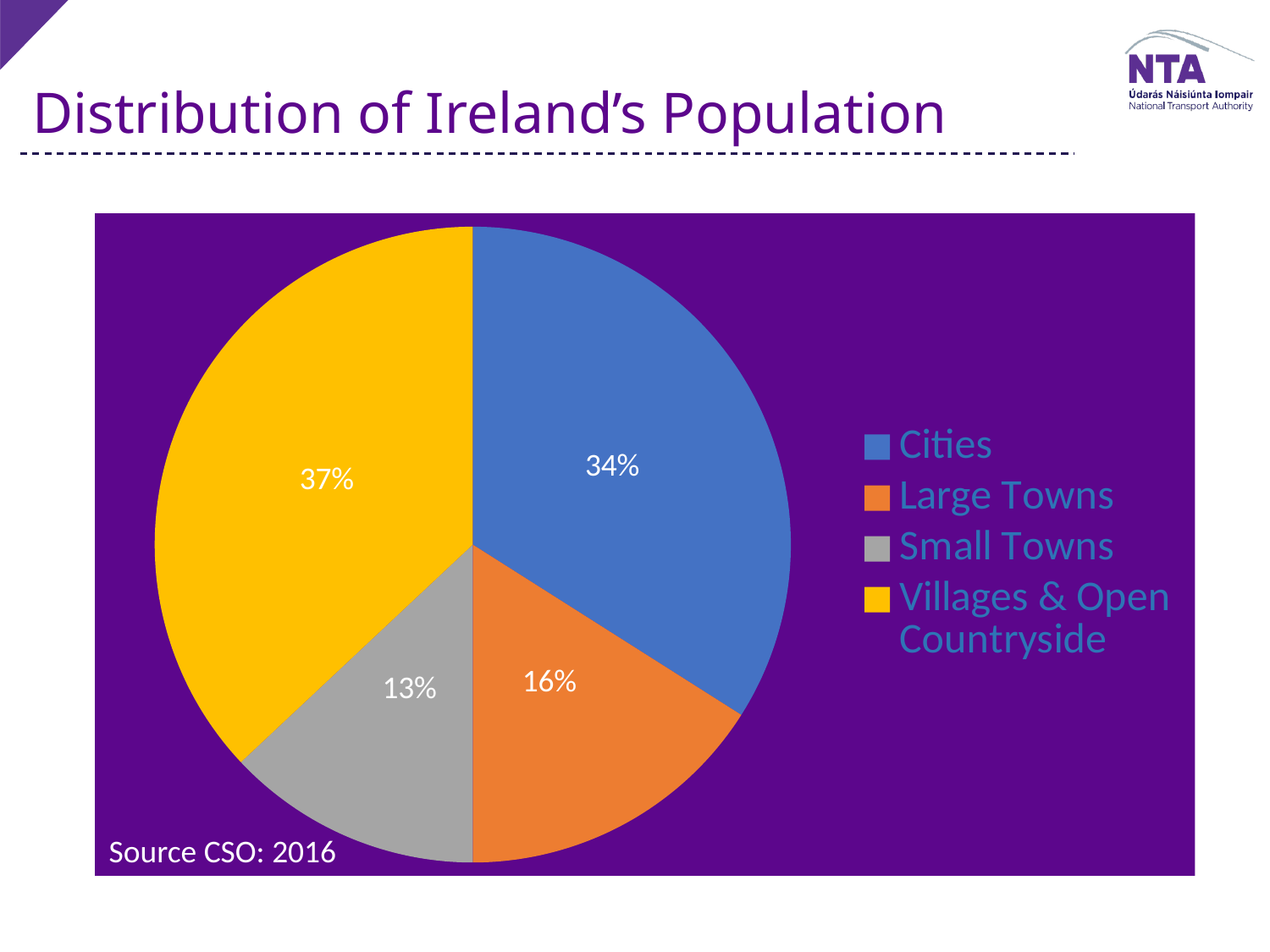
What is the title of the chart on the slide? Distribution of Ireland's Population What kind of chart is shown on the slide? Pie chart What share of Ireland's population lives in Small Towns? 13% What is the difference in percentage points between Villages & Open Countryside and Cities? 3 What share of Ireland's population lives in Villages & Open Countryside? 37% Which category has the largest share of the pie? Villages & Open Countryside How many categories does the pie chart show? 4 What share of Ireland's population lives in Large Towns? 16% What colour is the slice for Cities? Blue Which category has the smallest share of the pie? Small Towns What share of Ireland's population lives in Cities? 34% Which is larger, the share for Large Towns or the share for Small Towns? Large Towns